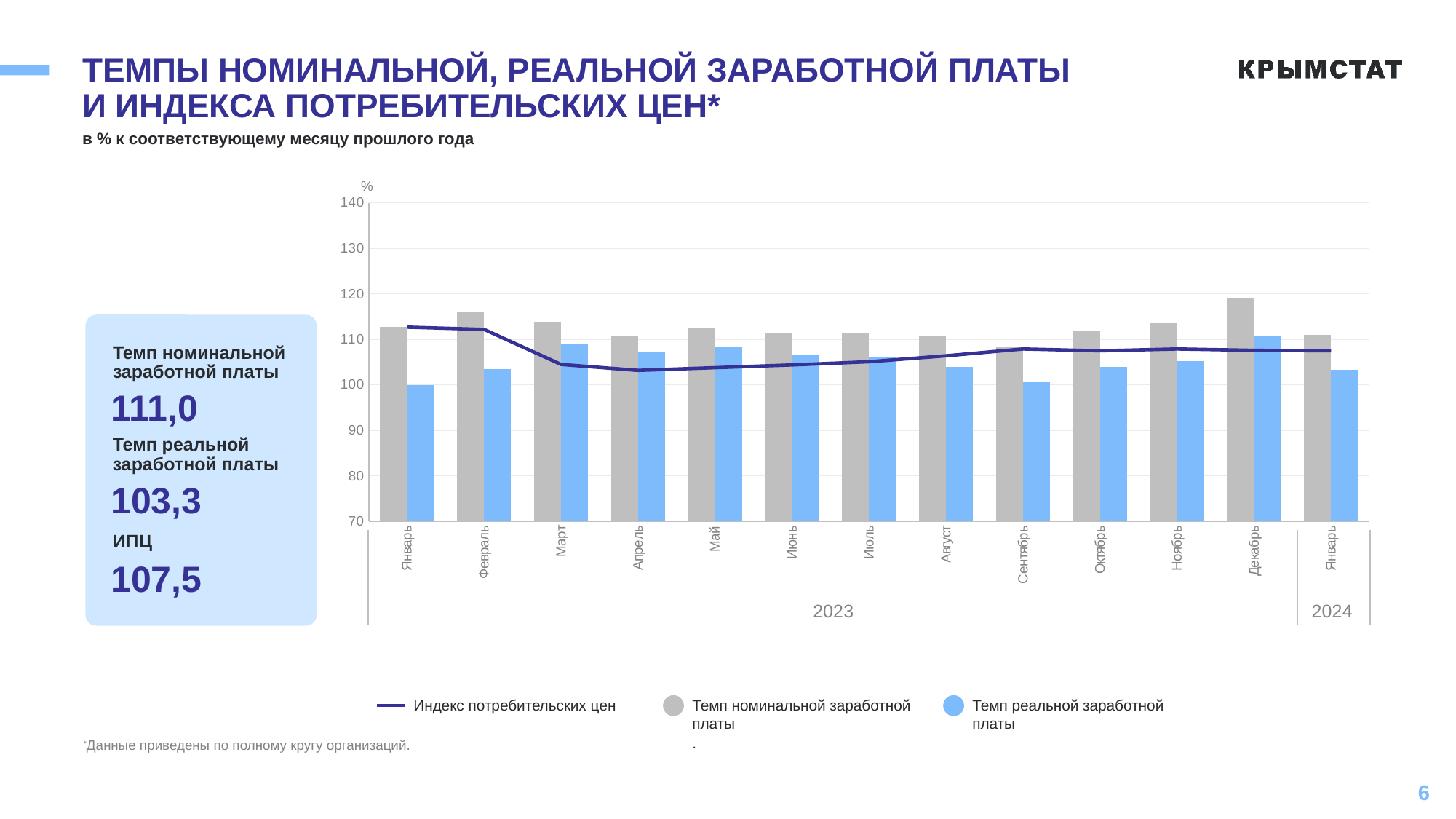
Which is larger in Декабрь: Темп номинальной заработной платы or Темп реальной заработной платы? Темп номинальной заработной платы Using the values in the callout box, what is the difference between Темп номинальной заработной платы and Темп реальной заработной платы? 7,7 According to the callout box, what is the value of Темп реальной заработной платы? 103,3 According to the callout box, what is the value of ИПЦ? 107,5 Does the Индекс потребительских цен line rise or fall from Январь 2023 to Апрель 2023? Falls How many series does the legend list? 3 How many months are plotted along the x axis? 13 According to the callout box, what is the value of Темп номинальной заработной платы? 111,0 Is the Темп номинальной заработной платы value for Декабрь greater or less than 110? greater In which month is the Темп номинальной заработной платы bar the highest? Декабрь What kind of chart is shown on the slide? A bar chart combined with a line Is the Темп реальной заработной платы value for Январь 2023 greater or less than 110? less